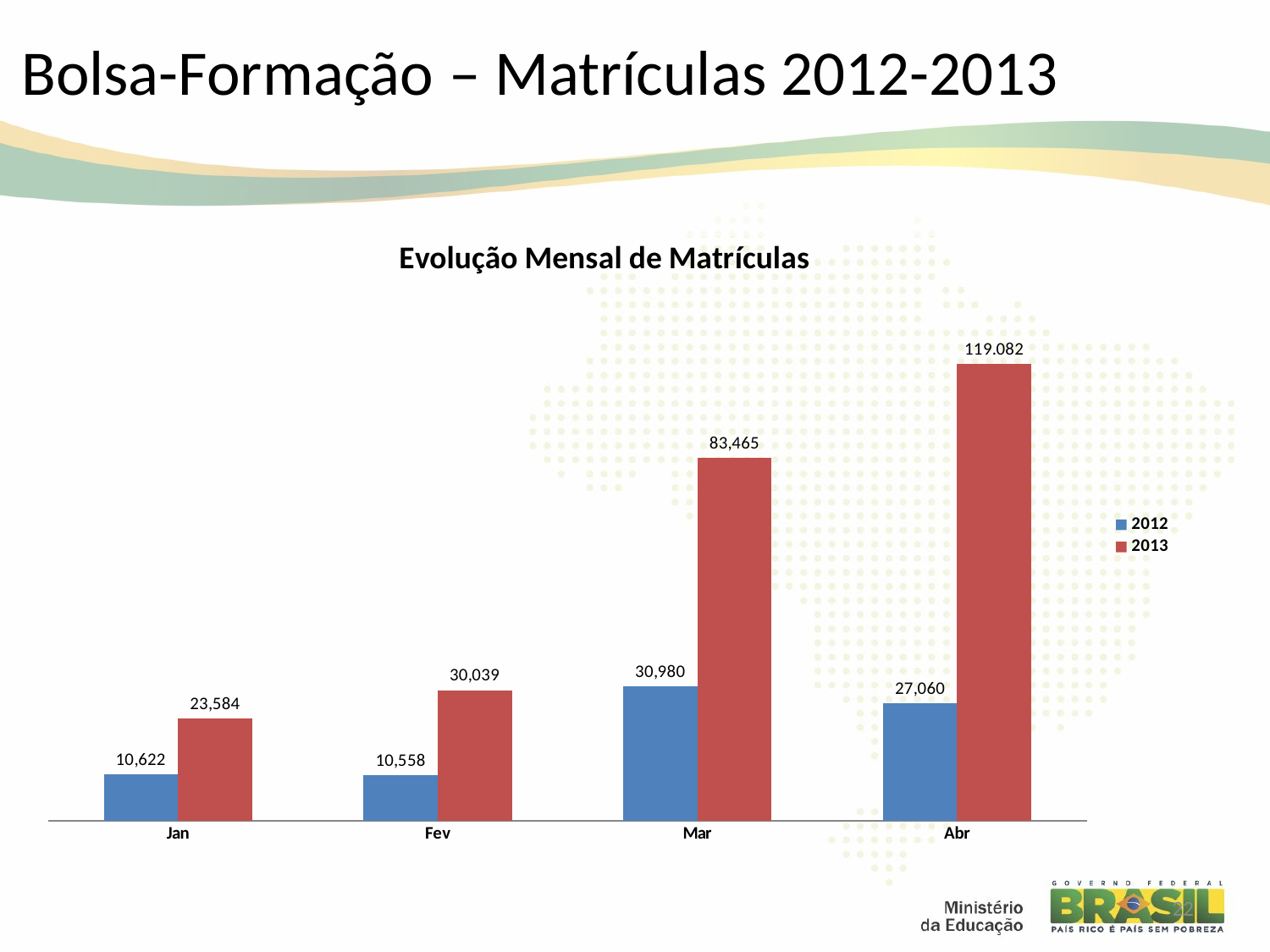
What is the difference between the 2013 and 2012 values in Jan? 12,962 What is the difference between the 2013 and 2012 values in Mar? 52,485 Which month has the lowest value for the 2012 series? Fev What is the value for 2013 in Abr? 119.082 How many series does the legend list? 2 What is the value for 2013 in Mar? 83,465 What is the value for 2012 in Jan? 10,622 How many months are shown on the x axis? 4 Which is larger, the 2012 value in Mar or the 2012 value in Abr? Mar What is the value for 2012 in Fev? 10,558 Which month has the highest value for the 2012 series? Mar Which month has the highest value for the 2013 series? Abr